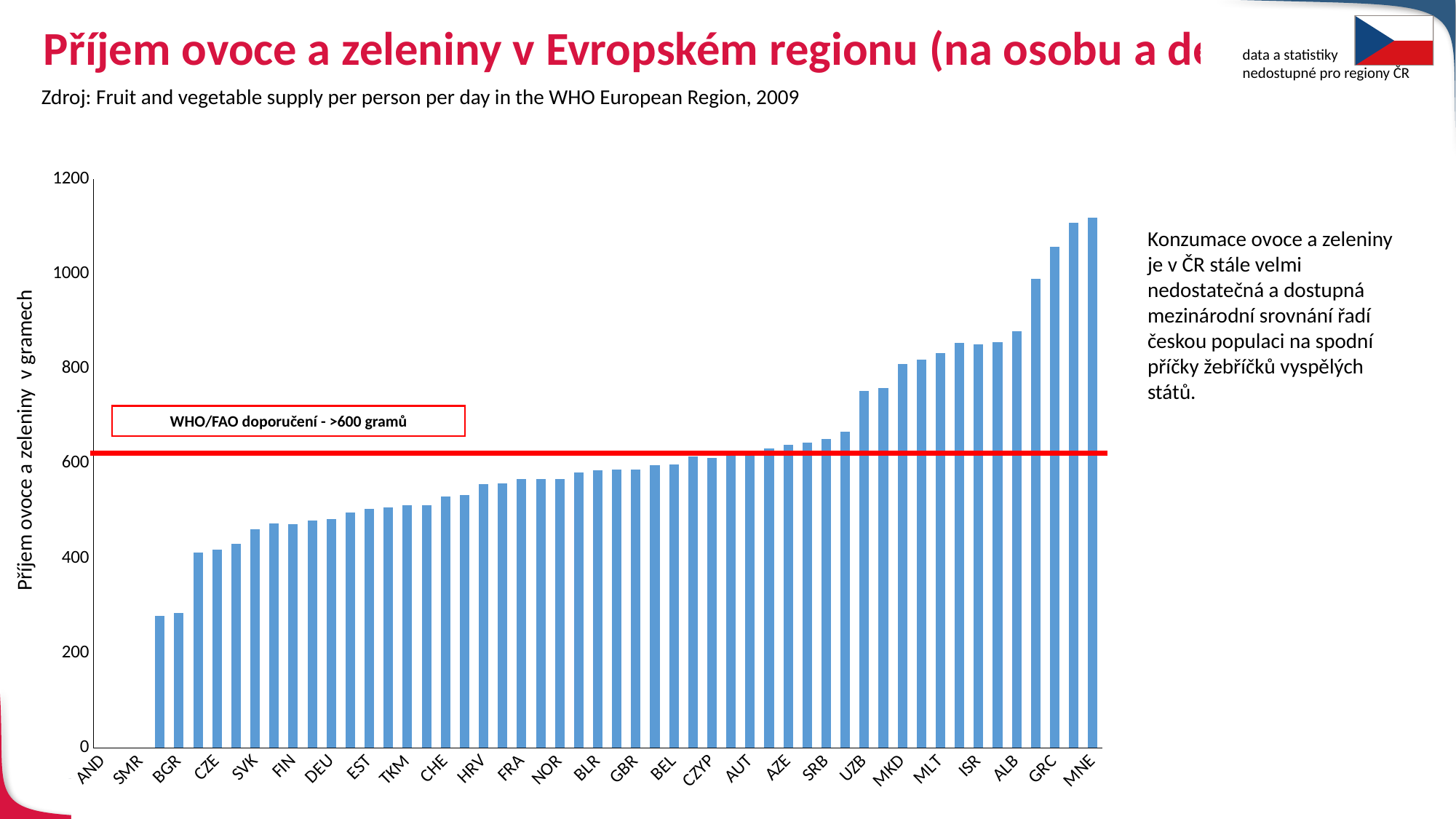
Which has a larger value, GRC or DEU? GRC Which has a larger value, MNE or CZE? MNE Is the value for CZE greater or less than 600? less Which labelled country has the highest fruit and vegetable supply in the chart? MNE Is the value for ALB greater or less than 800? greater What does the red horizontal line in the chart represent, according to its label? WHO/FAO doporučení - >600 gramů Is the value for UZB greater or less than 600? greater What kind of chart is shown on the slide? bar chart Do the bar values rise or fall from left to right along the x axis? rise